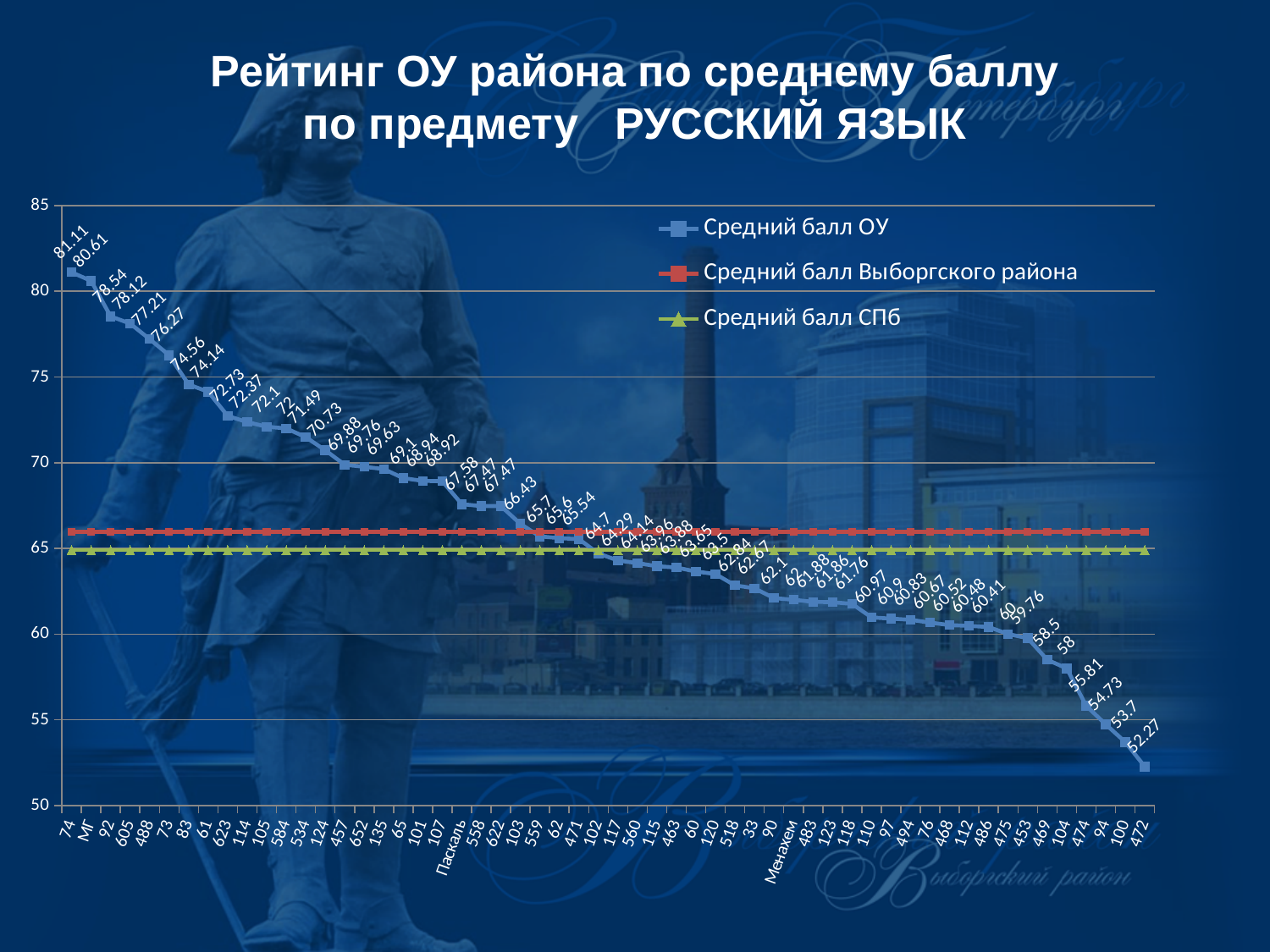
Is the value of Средний балл Выборгского района greater or less than 65? greater Which subject is named in the chart title? РУССКИЙ ЯЗЫК What is the Средний балл ОУ for the school labelled МГ? 80.61 What is the lowest value of Средний балл ОУ shown on the chart? 52.27 Which school (x-axis category) has the lowest Средний балл ОУ? 472 Do the Средний балл ОУ values rise or fall from left to right along the x axis? fall What is the difference between the highest (81.11) and lowest (52.27) Средний балл ОУ values? 28.84 Which school (x-axis category) has the highest Средний балл ОУ? 74 What is the highest value of Средний балл ОУ shown on the chart? 81.11 What kind of chart is shown on the slide? line chart How many series does the legend list? 3 Which has a higher Средний балл ОУ, school 74 or school 472? 74